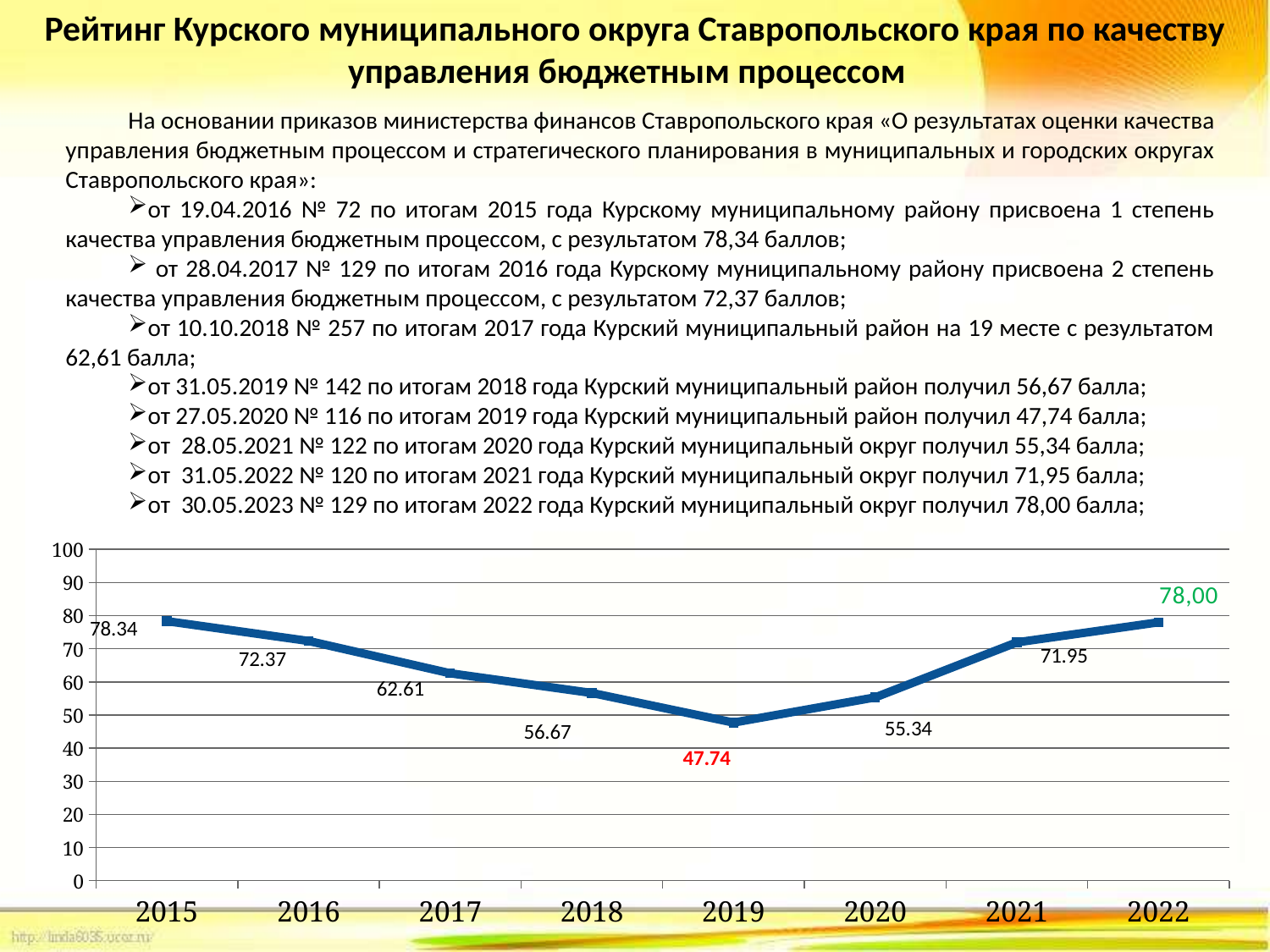
Which year has the highest value on the chart? 2015 Do the values rise or fall from 2015 to 2019? fall How many years are plotted on the chart? 8 What is the value plotted for 2015? 78.34 What is the difference between the values for 2021 and 2020? 16.61 What is the value plotted for 2022? 78,00 What is the value plotted for 2020? 55.34 Which year has the lowest value on the chart? 2019 What is the difference between the values for 2015 and 2019? 30.60 What kind of chart is shown on the slide? line chart Which is larger, the value for 2017 or the value for 2018? 2017 What is the value plotted for 2019? 47.74